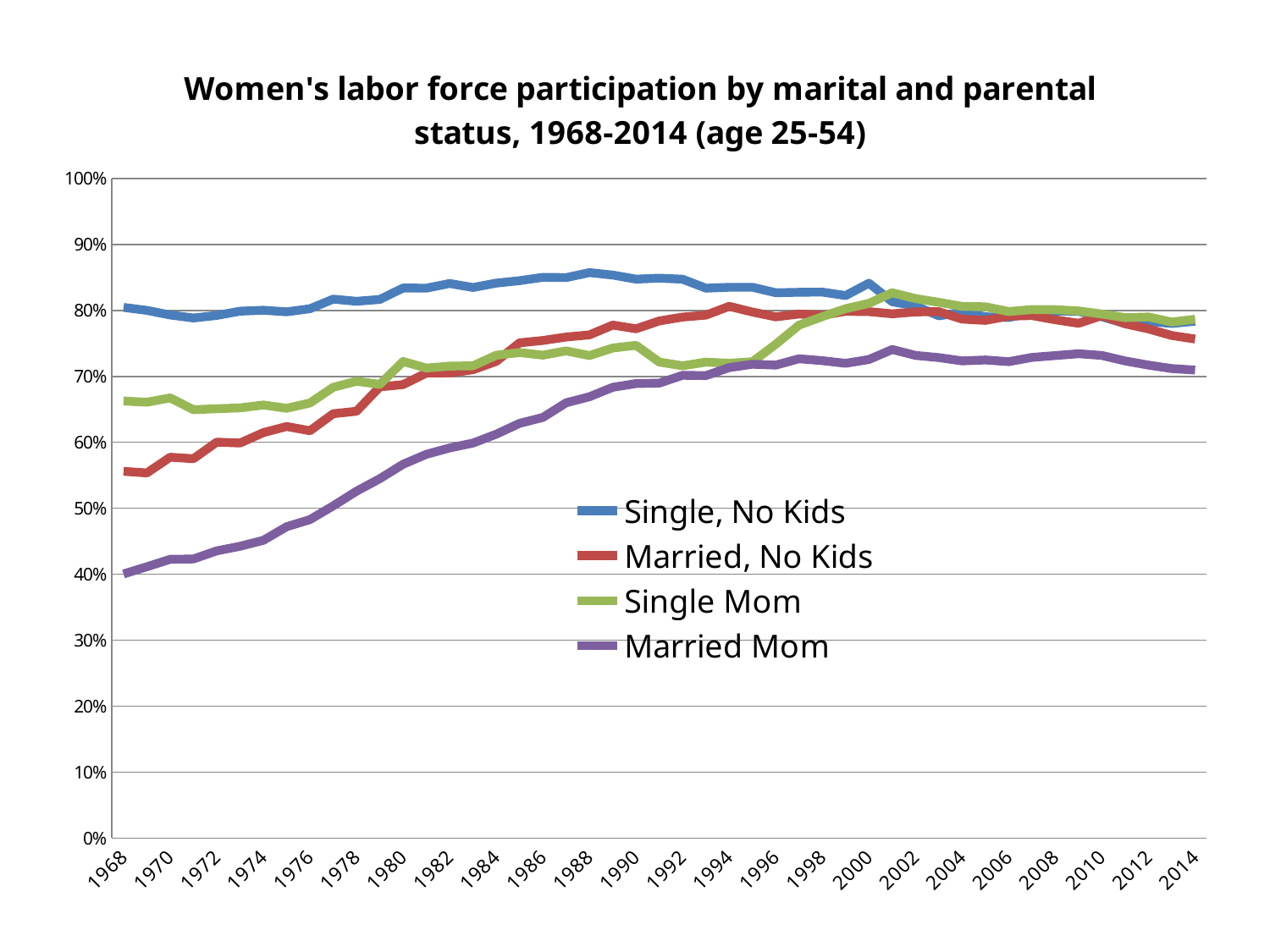
Is the value for Married Mom in 1968 greater or less than 50%? less In 1968, which is larger: Married, No Kids or Single Mom? Single Mom Which series has the highest value in 1968? Single, No Kids Is the value for Single, No Kids in 1968 greater or less than 70%? greater What is the title of the chart? Women's labor force participation by marital and parental status, 1968-2014 (age 25-54) Which colour is used for the Single Mom series? Green Which series has the lowest value in 1968? Married Mom What kind of chart is shown on the slide? Line chart How many series does the legend list? 4 Does the Married Mom series rise or fall from 1968 to 2014? Rise Is the value for Married Mom in 2014 greater or less than 60%? greater Which series has the lowest value in 2014? Married Mom